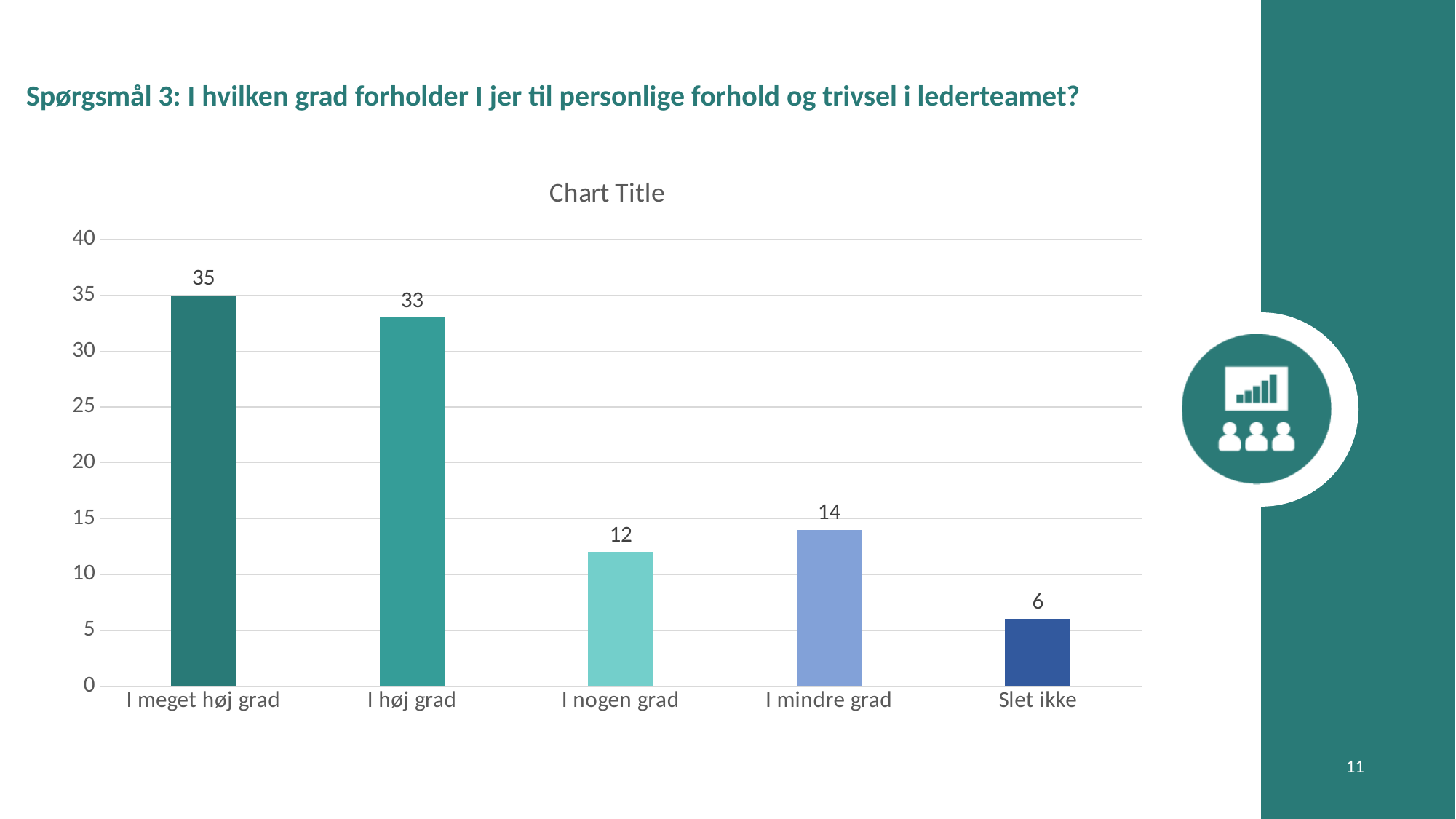
What is the difference between the values for "I mindre grad" and "Slet ikke"? 8 What is the value for "I meget høj grad"? 35 Which category has the lowest value? Slet ikke What is the title shown above the chart? Chart Title What kind of chart is shown on the slide? bar chart What is the value for "I nogen grad"? 12 Is the value for "I høj grad" greater or less than 30? greater What is the difference between the values for "I meget høj grad" and "I høj grad"? 2 Which is larger, the value for "I nogen grad" or the value for "I mindre grad"? I mindre grad Which category has the highest value? I meget høj grad How many categories are shown on the x axis? 5 What is the value for "Slet ikke"? 6